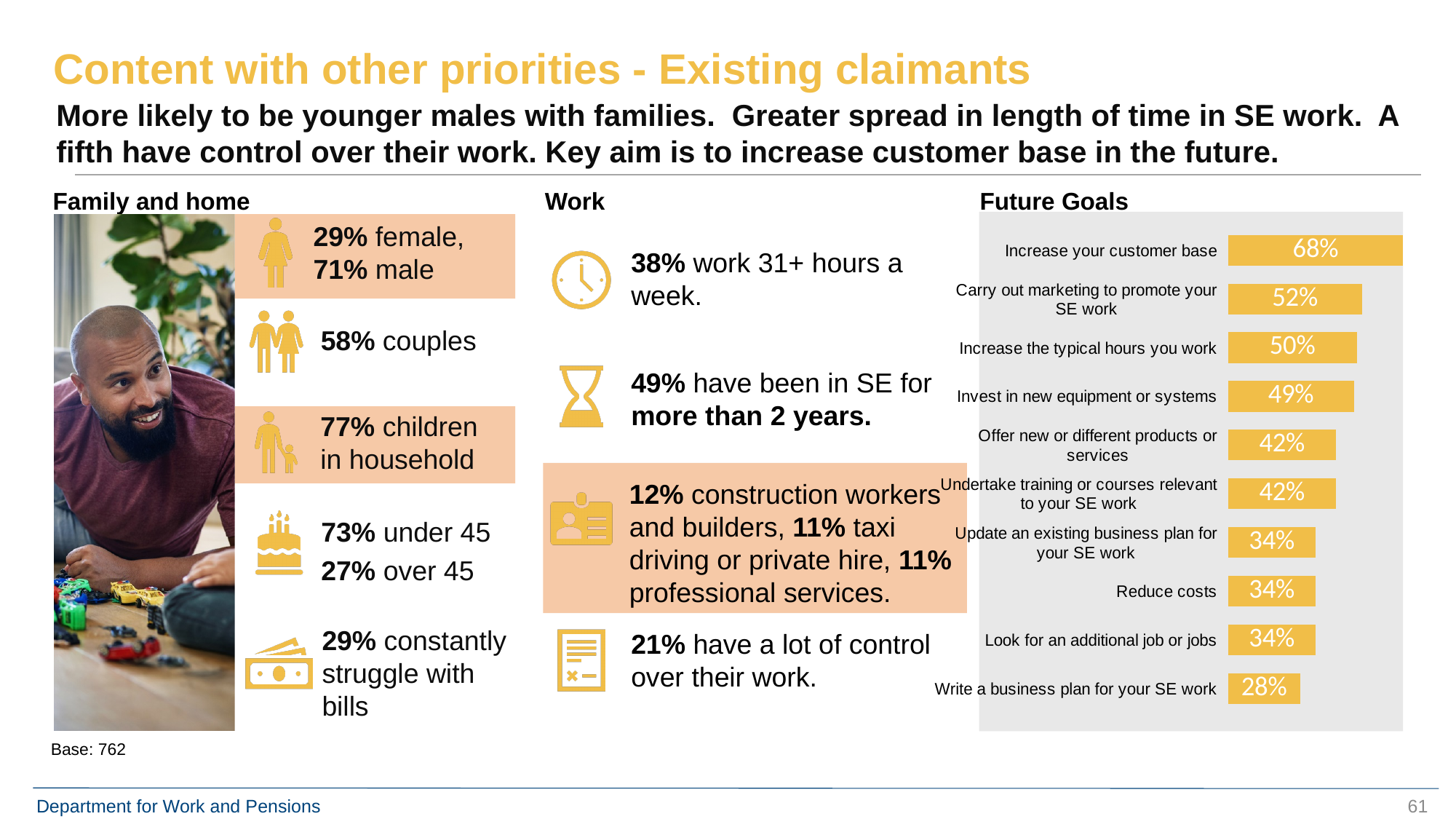
What kind of chart is the Future Goals chart? Bar chart In the Future Goals chart, what is the value for 'Increase your customer base'? 68% In the Future Goals chart, which is larger: 'Offer new or different products or services' or 'Reduce costs'? Offer new or different products or services In the Future Goals chart, what is the value for 'Write a business plan for your SE work'? 28% In the Future Goals chart, how many categories have a value of 34%? 3 In the Future Goals chart, which category has the highest value? Increase your customer base In the Future Goals chart, what is the value for 'Carry out marketing to promote your SE work'? 52% In the Future Goals chart, what is the difference between 'Increase your customer base' and 'Write a business plan for your SE work'? 40% How many categories does the Future Goals chart show? 10 In the Future Goals chart, what is the difference between 'Carry out marketing to promote your SE work' and 'Increase the typical hours you work'? 2% In the Future Goals chart, which category has the lowest value? Write a business plan for your SE work In the Future Goals chart, what is the value for 'Invest in new equipment or systems'? 49%